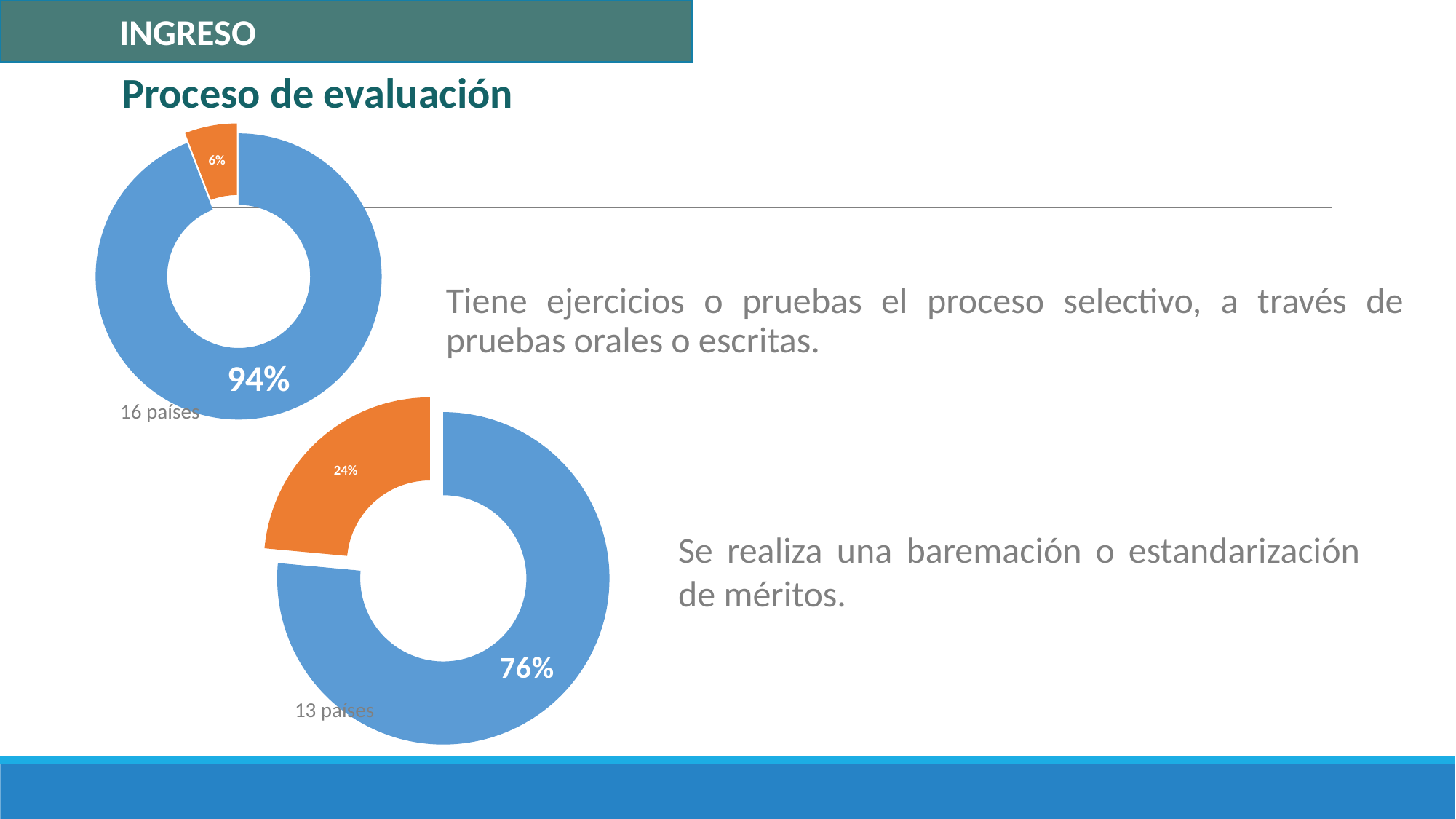
In the top chart, what is the difference between the blue and orange percentages? 88% What kind of chart is the top chart on the slide? doughnut chart In the bottom chart, which segment is smaller, the blue one or the orange one? orange What label appears below the bottom chart indicating the number of countries? 13 países In the bottom chart, what is the difference between the blue and orange percentages? 52% In the top chart, what percentage does the blue segment show? 94% In the bottom chart, what percentage does the orange segment show? 24% In the top chart, what percentage does the orange segment show? 6% In the bottom chart, what percentage does the blue segment show? 76% In the top chart, which segment is larger, the blue one or the orange one? blue How many segments does the bottom chart have? 2 What label appears below the top chart indicating the number of countries? 16 países